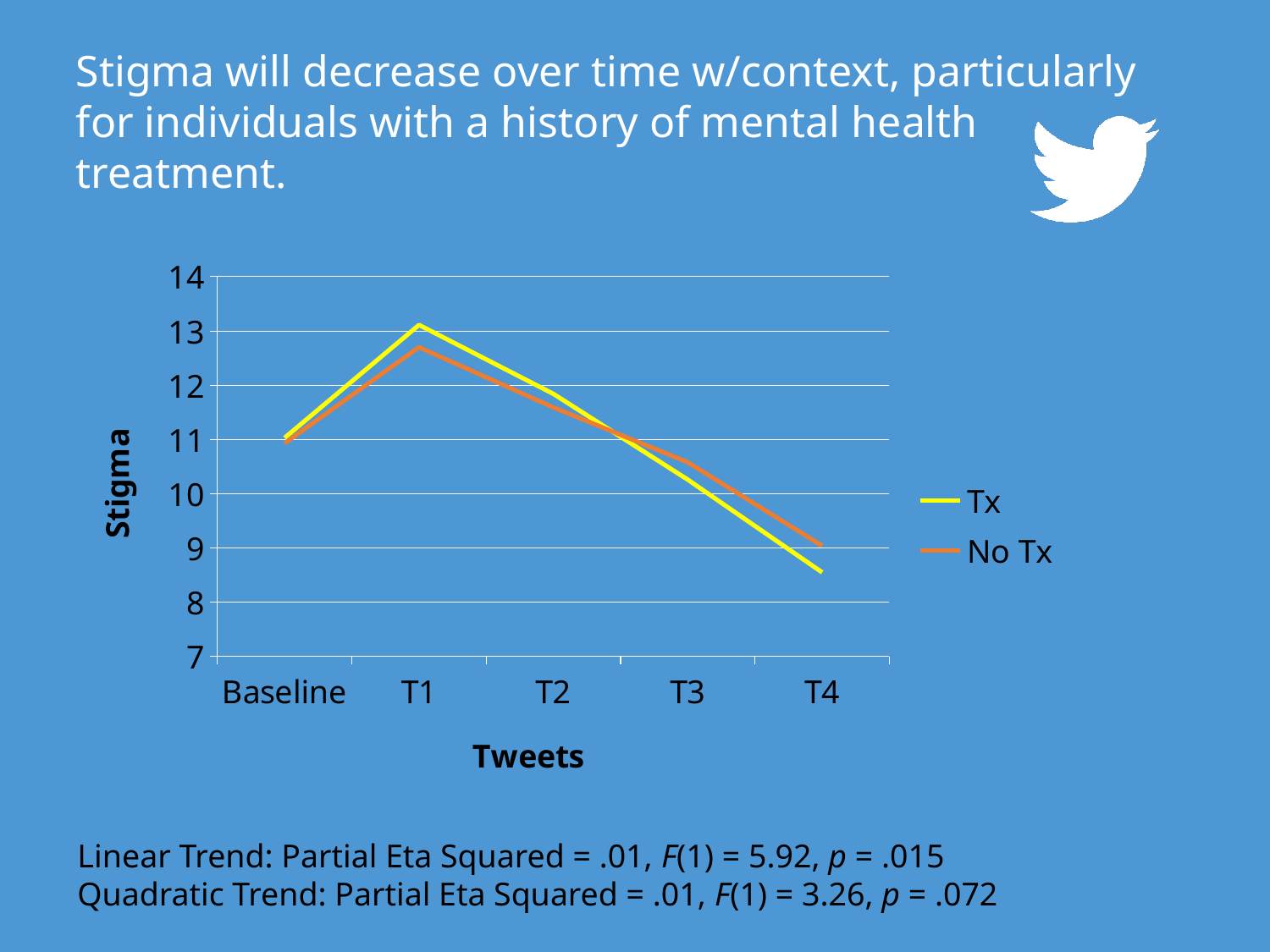
At which time point does the Tx series reach its lowest value? T4 At which time point does the Tx series reach its highest value? T1 From T1 to T4, do the Tx values rise or fall? fall Is the value for Tx at T4 greater or less than 9? less Is the value for No Tx at T1 greater or less than 12? greater What is the title of the vertical axis? Stigma How many series does the legend list? 2 Is the value for No Tx at T3 greater or less than 11? less What kind of chart is shown on the slide? line chart At T4, which series has the higher value, Tx or No Tx? No Tx How many time points are plotted along the x axis? 5 At T1, which series has the higher value, Tx or No Tx? Tx